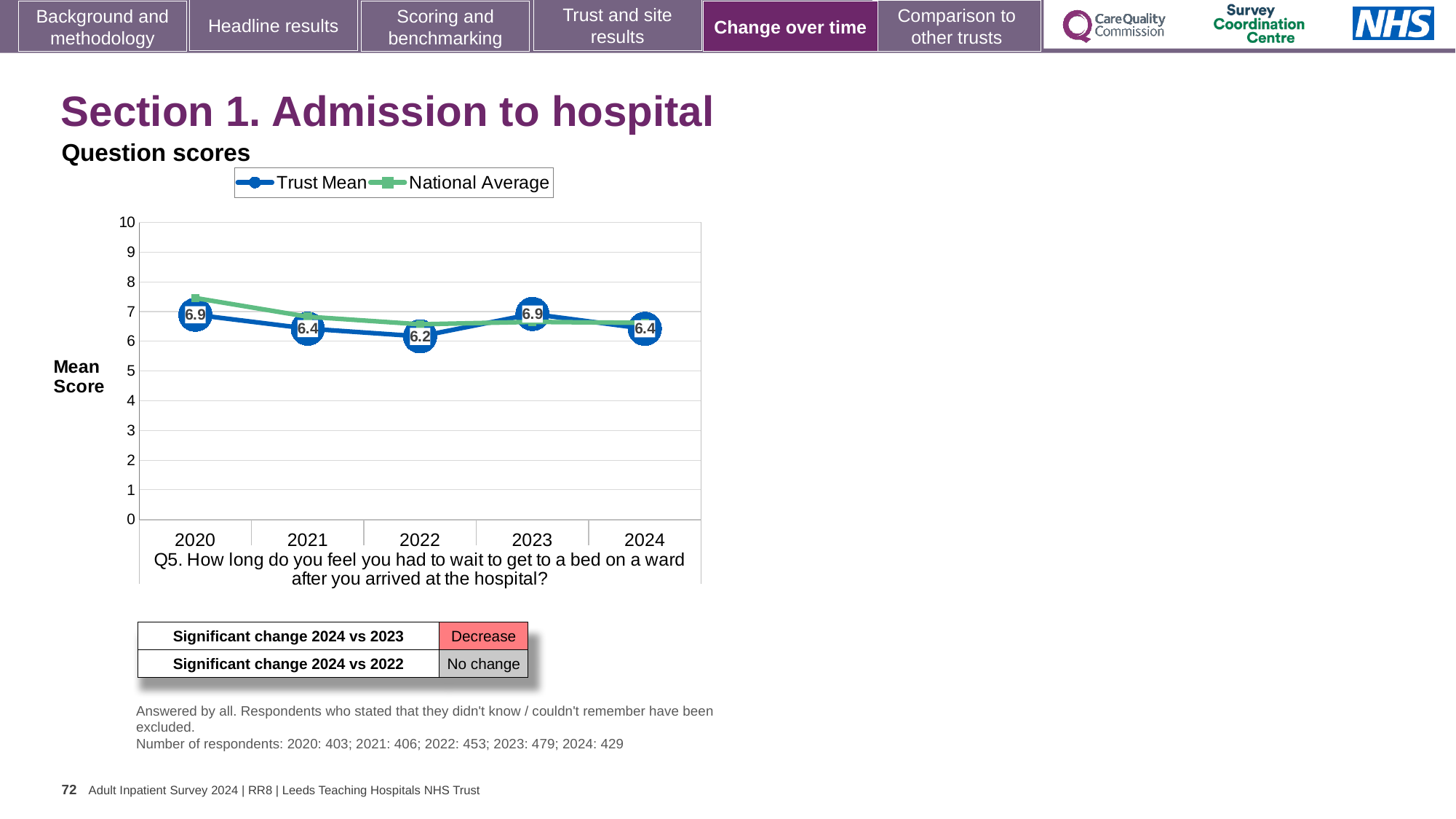
What is the Trust Mean score for 2020? 6.9 In which year is the Trust Mean score lowest? 2022 What are the two series named in the chart legend? Trust Mean and National Average How many years are shown on the x axis of the chart? 5 How many series does the chart legend list? 2 What is the Trust Mean score for 2022? 6.2 What kind of chart is shown on the slide? Line chart What is the Trust Mean score for 2024? 6.4 Is the National Average value for 2020 greater or less than 7? greater Does the Trust Mean score rise or fall from 2020 to 2022? Fall What is the difference between the Trust Mean scores for 2023 and 2024? 0.5 Which is larger, the Trust Mean score for 2021 or for 2022? 2021